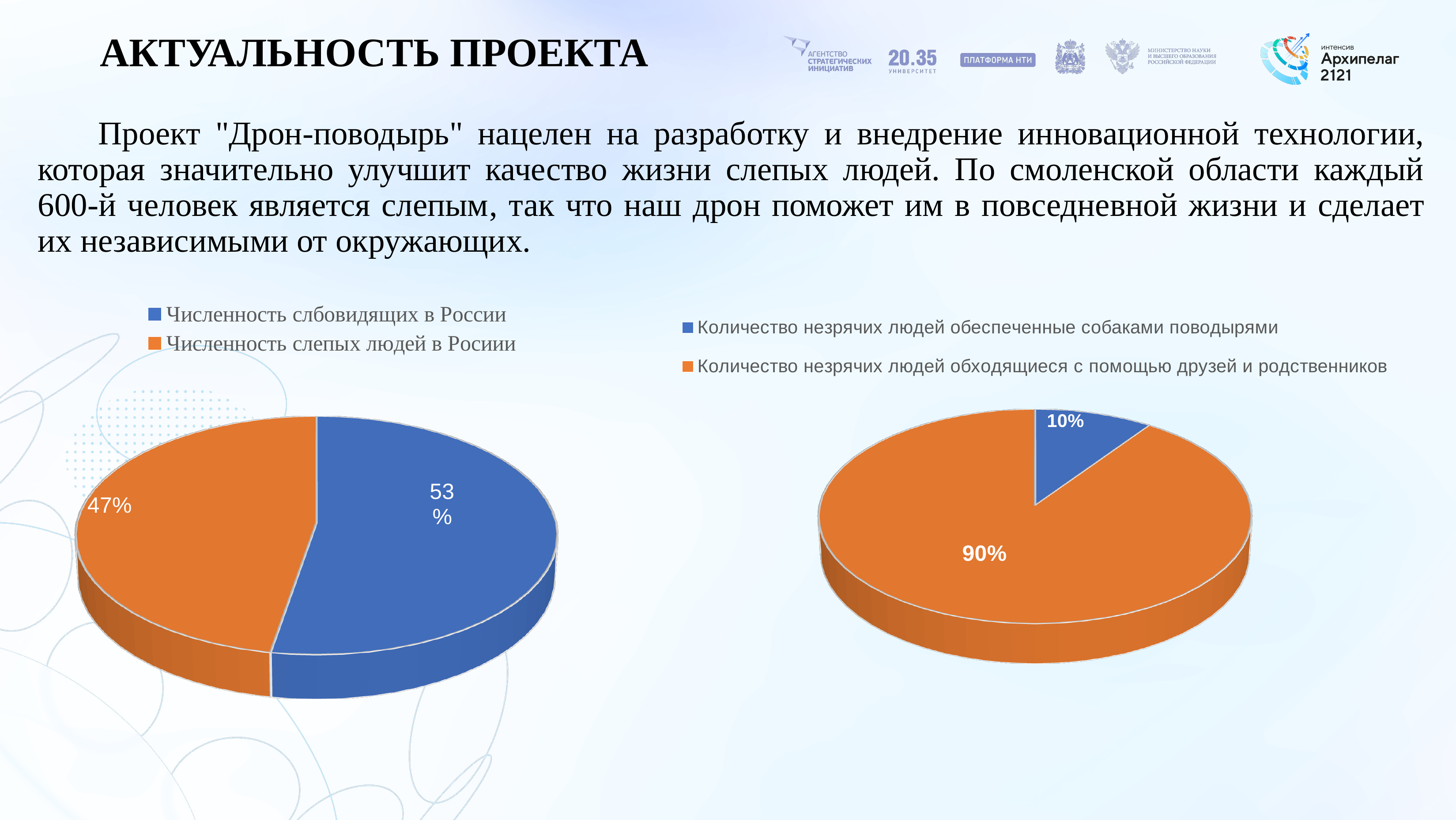
In the left pie chart, what is the difference in percentage points between the two slices? 6 How many entries does the legend of the right pie chart list? 2 In the left pie chart, what share is shown for "Численность слепых людей в Росиии"? 47% In the left pie chart, what share is shown for "Численность слбовидящих в России"? 53% In the right pie chart, which category has the smallest slice? Количество незрячих людей обеспеченные собаками поводырями How many slices does the left pie chart have? 2 What type of chart is the left chart on the slide? Pie chart In the right pie chart, what is the difference in percentage points between the two slices? 80 In the right pie chart, what share is shown for "Количество незрячих людей обходящиеся с помощью друзей и родственников"? 90% In the right pie chart, what share is shown for "Количество незрячих людей обеспеченные собаками поводырями"? 10% In the right pie chart, what colour is the slice labelled 90%? Orange In the left pie chart, which category has the larger slice? Численность слбовидящих в России